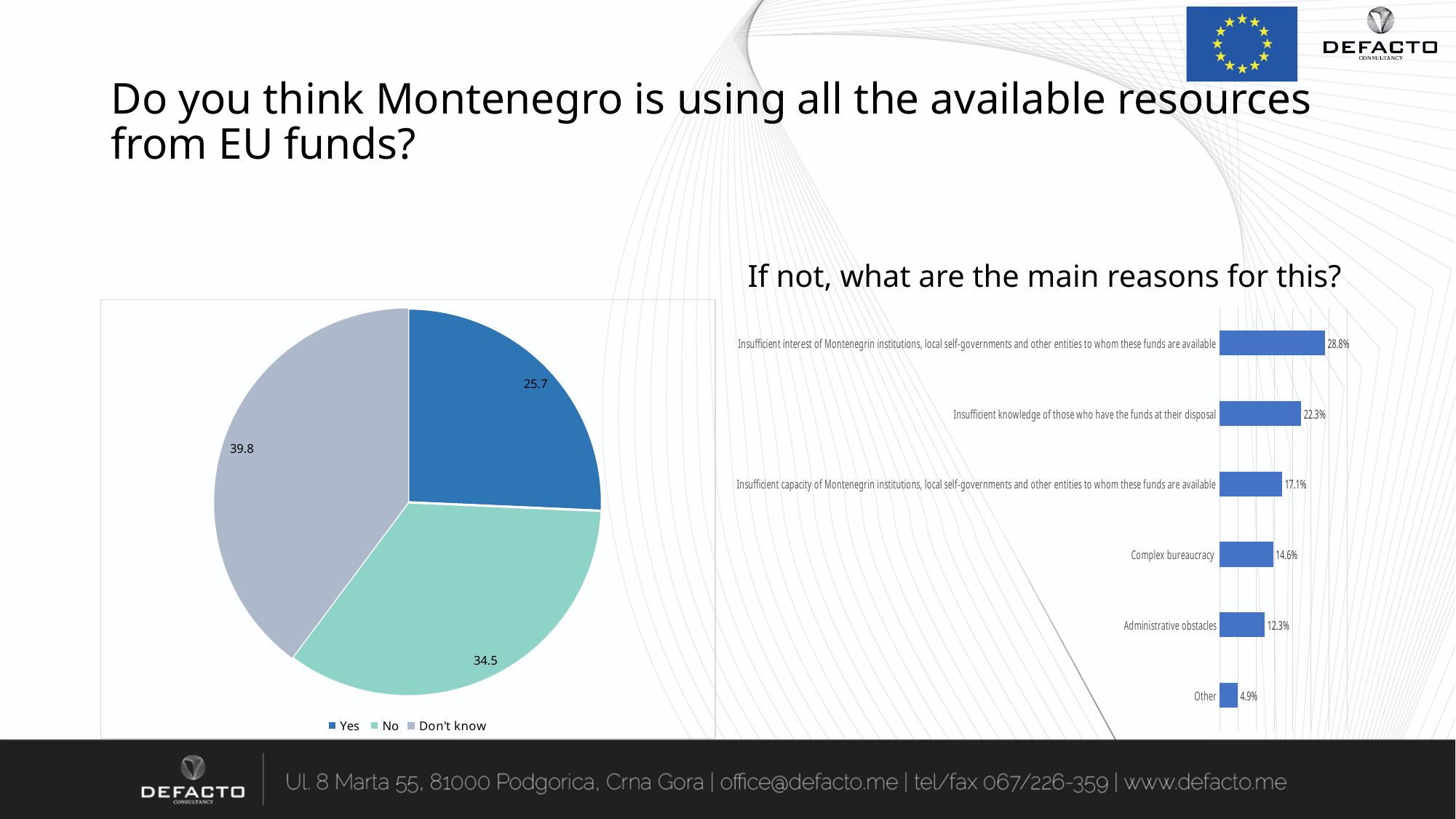
In the chart titled 'If not, what are the main reasons for this?', how many reasons (bars) are shown? 6 In the chart titled 'If not, what are the main reasons for this?', what is the value for 'Other'? 4.9% In the pie chart on the left, what is the difference between the 'No' and 'Yes' values? 8.8 In the pie chart on the left, which response has the largest slice? Don't know In the chart titled 'If not, what are the main reasons for this?', what is the value for 'Complex bureaucracy'? 14.6% What type of chart is shown on the left side of the slide? Pie chart In the pie chart on the left, how many entries does the legend list? 3 In the chart titled 'If not, what are the main reasons for this?', what is the difference between 'Insufficient knowledge of those who have the funds at their disposal' and 'Administrative obstacles'? 10.0% In the pie chart on the left, what value is shown for the 'Don't know' slice? 39.8 In the pie chart on the left, which response has the smallest slice? Yes In the chart titled 'If not, what are the main reasons for this?', which reason has the highest value? Insufficient interest of Montenegrin institutions, local self-governments and other entities to whom these funds are available In the pie chart on the left, what value is shown for the 'Yes' slice? 25.7